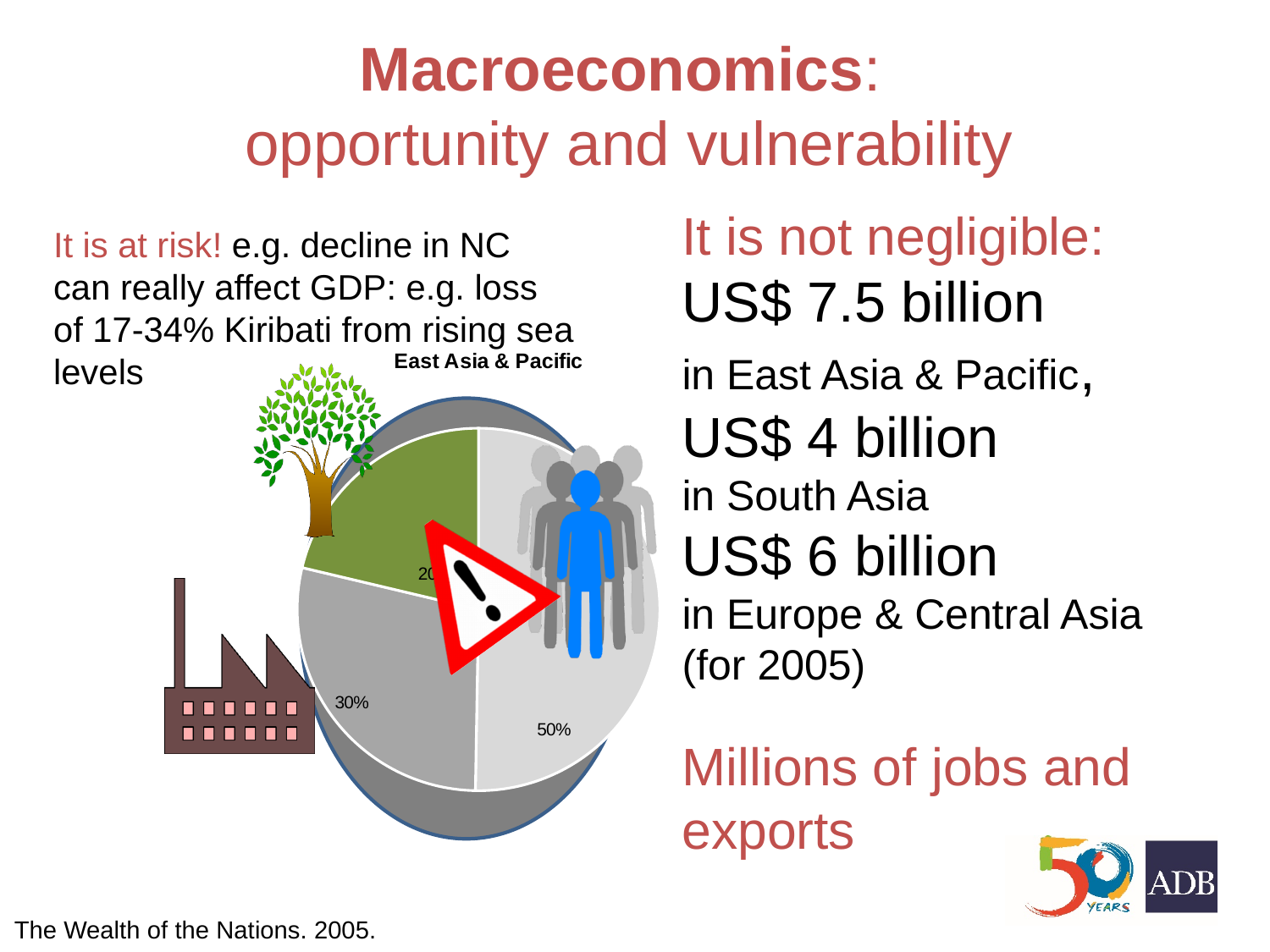
What is the difference between the 50% slice and the 30% slice in the pie chart? 20 percentage points What is the value of the largest slice of the pie chart? 50% How many slices does the pie chart have? 3 What percentage is shown on the light gray slice of the pie chart? 50% What percentage is shown on the darker gray slice of the pie chart? 30% What share of the pie does the light gray slice represent? 50% Is the green slice of the pie chart greater or less than 50%? less What kind of chart is shown on the slide? Pie chart Which is larger in the pie chart: the 50% slice or the 30% slice? The 50% slice Which slice of the pie chart is the smallest? The green slice What colour is the smallest slice of the pie chart? Green What is the title of the pie chart? East Asia & Pacific